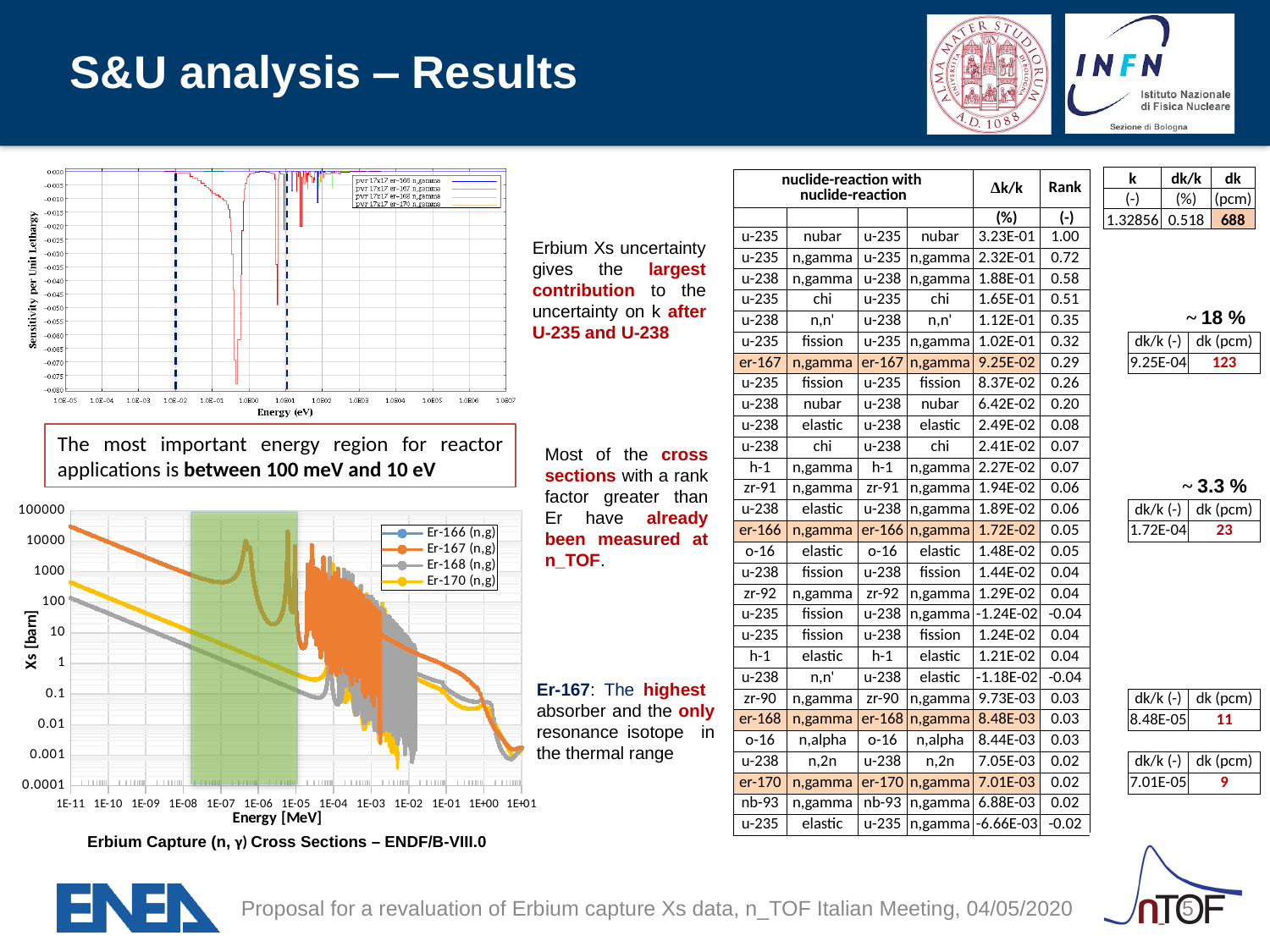
In the bottom-left Erbium Capture cross section chart, does the Er-167 (n,g) cross section generally rise or fall as energy increases from 1E-11 MeV to 1E-08 MeV? Fall How many series does the legend of the top-left sensitivity chart list? 4 What kind of chart is the bottom-left chart titled 'Erbium Capture (n, γ) Cross Sections – ENDF/B-VIII.0'? Line chart What is the y-axis label of the top-left sensitivity chart? Sensitivity per Unit Lethargy What is the x-axis label of the bottom-left Erbium Capture cross section chart? Energy [MeV] In the bottom-left Erbium Capture cross section chart, is the Er-170 (n,g) cross section at 1E-11 MeV greater or less than 100 barn? greater How many series does the legend of the bottom-left Erbium Capture cross section chart list? 4 In the bottom-left Erbium Capture cross section chart, which series is plotted lowest at the lowest energies (around 1E-11 MeV)? Er-168 (n,g) In the top-left sensitivity chart, which series shows the deepest negative dip (reaching about -0.080)? pwr 17x17 er-167 n,gamma In the bottom-left Erbium Capture cross section chart, is the Er-167 (n,g) cross section at 1E-11 MeV greater or less than 1000 barn? greater In the bottom-left Erbium Capture cross section chart, which series is plotted highest at the lowest energies (around 1E-11 MeV)? Er-167 (n,g) What is the y-axis label of the bottom-left Erbium Capture cross section chart? Xs [barn]